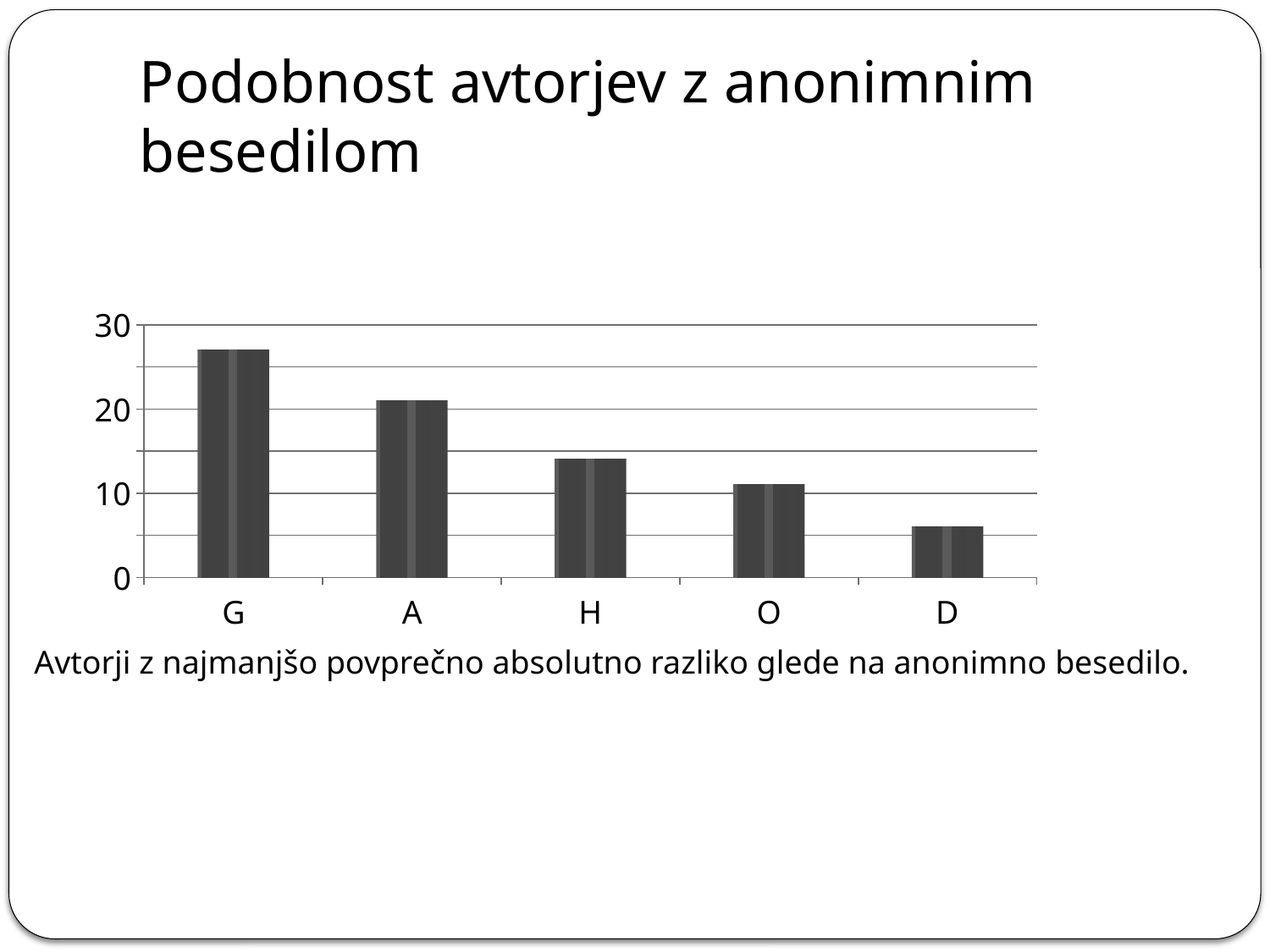
Is the value for O greater or less than 10? greater What is the title of the slide containing the chart? Podobnost avtorjev z anonimnim besedilom Is the value for A greater or less than 20? greater Is the value for H greater or less than 20? less Which category has the highest bar in the chart? G Which category has the lowest bar in the chart? D How many categories are shown on the x axis of the chart? 5 Which is larger, the value for A or the value for H? A What kind of chart is shown on the slide? bar chart Do the bar values rise or fall from left to right along the x axis? fall